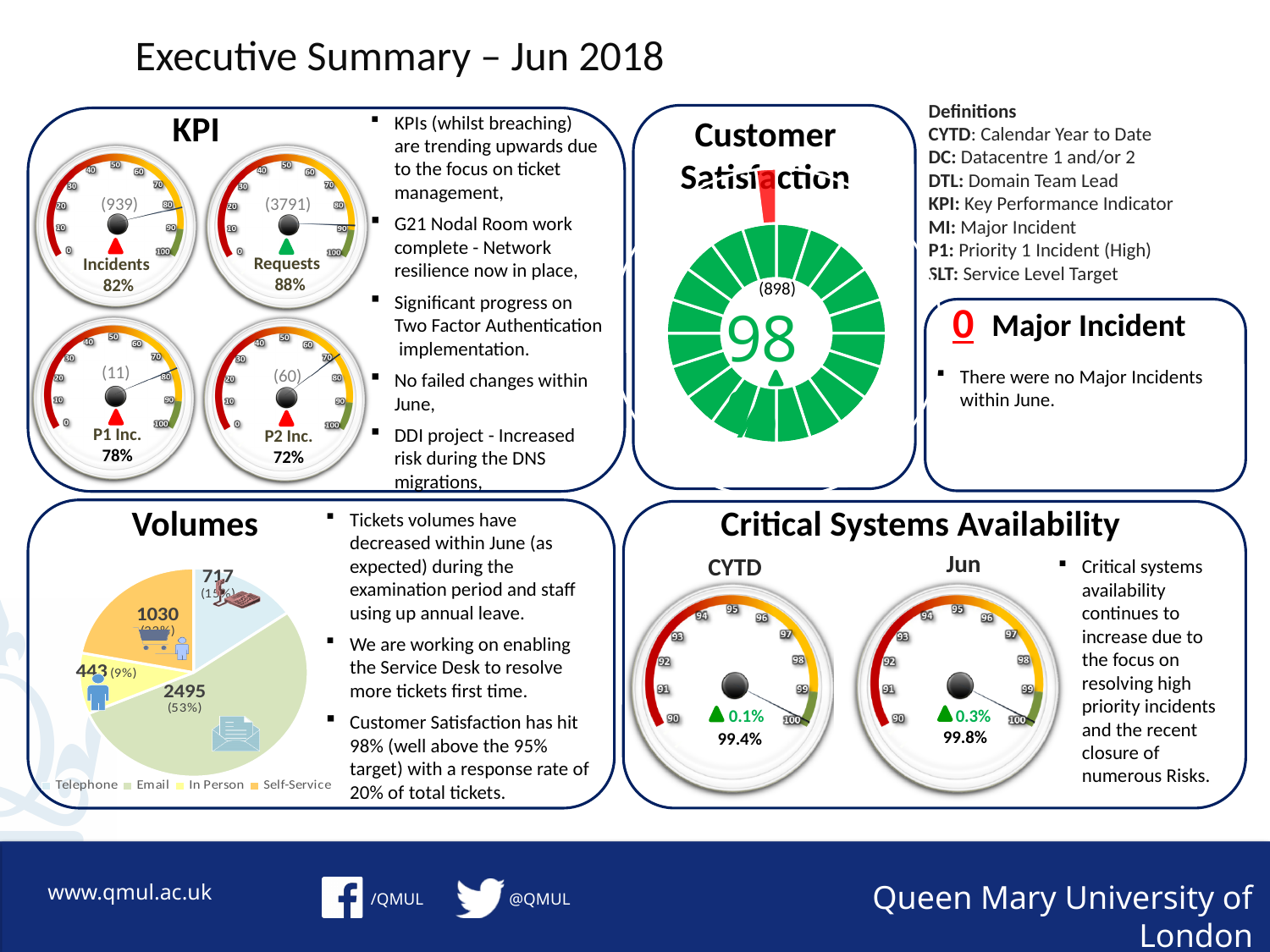
On the Volumes pie chart, what share of the total does the 2495 slice represent? 53% On the KPI gauges, what percentage is shown for Requests? 88% On the Critical Systems Availability gauges, what is the availability for Jun? 99.8% On the KPI gauges, what is the difference between the Requests percentage and the P1 Inc. percentage? 10% On the Customer Satisfaction chart, what score is shown in the centre? 98 On the KPI gauges, which of the four KPIs has the lowest percentage? P2 Inc. On the Volumes pie chart, how many categories does the legend list? 4 On the Critical Systems Availability gauges, which is higher, CYTD or Jun? Jun On the KPI gauges, what percentage is shown for Incidents? 82% On the Volumes pie chart, what is the value of the largest slice? 2495 On the KPI gauges, what count is shown in parentheses on the Requests gauge? 3791 On the Customer Satisfaction chart, what number is shown in parentheses above the score? 898